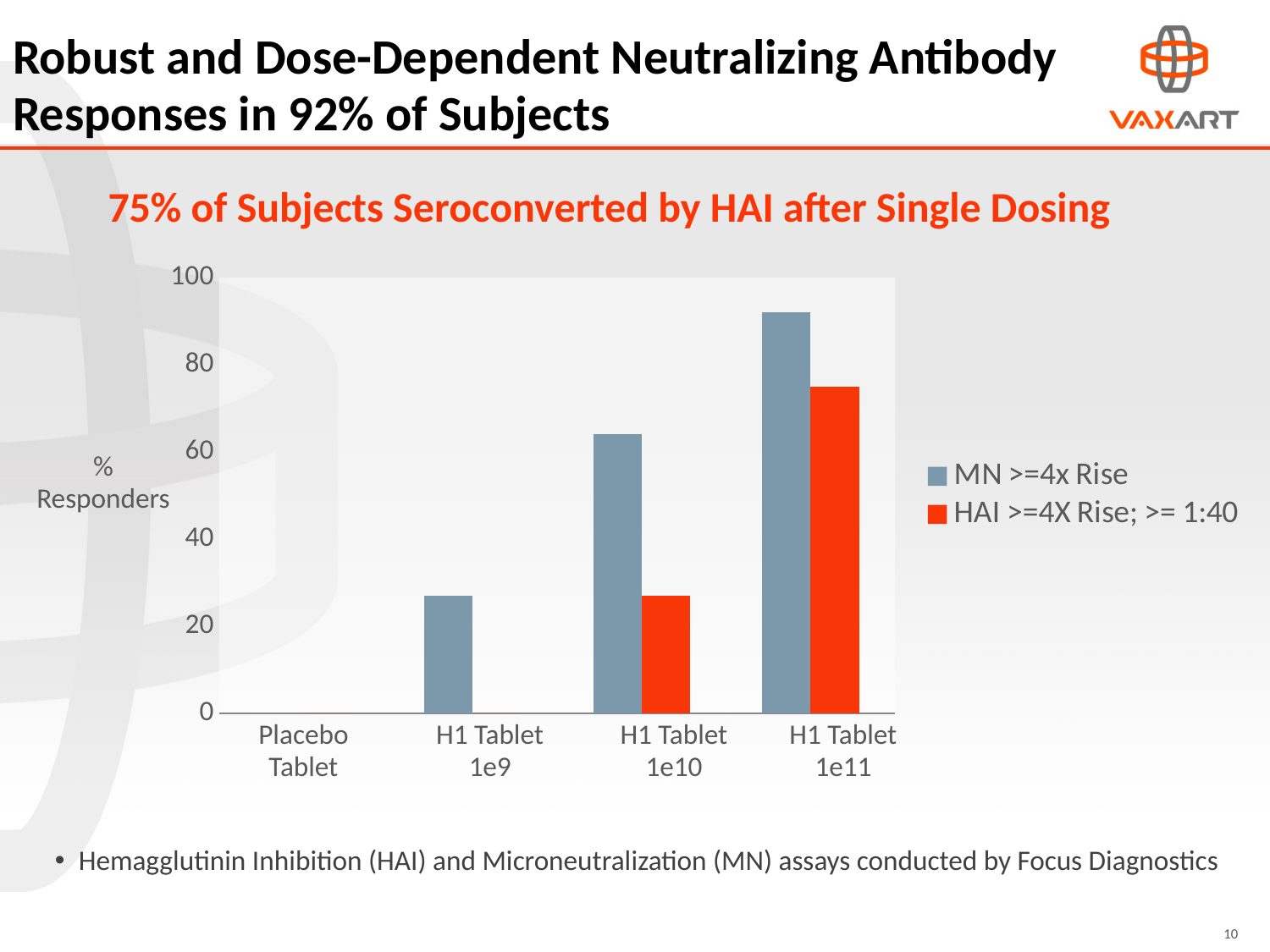
Is the HAI >=4X Rise; >= 1:40 value for H1 Tablet 1e10 greater or less than 40? less What is the label of the y axis? % Responders Is the HAI >=4X Rise; >= 1:40 value for H1 Tablet 1e11 greater or less than 60? greater For H1 Tablet 1e10, which series has the larger value, MN >=4x Rise or HAI >=4X Rise; >= 1:40? MN >=4x Rise How many categories are shown on the x axis? 4 How many series does the legend list? 2 Which category has the highest MN >=4x Rise value? H1 Tablet 1e11 Which category has the highest HAI >=4X Rise; >= 1:40 value? H1 Tablet 1e11 Is the MN >=4x Rise value for H1 Tablet 1e11 greater or less than 80? greater Do the MN >=4x Rise values rise or fall from Placebo Tablet to H1 Tablet 1e11? rise What kind of chart is shown on the slide? bar chart